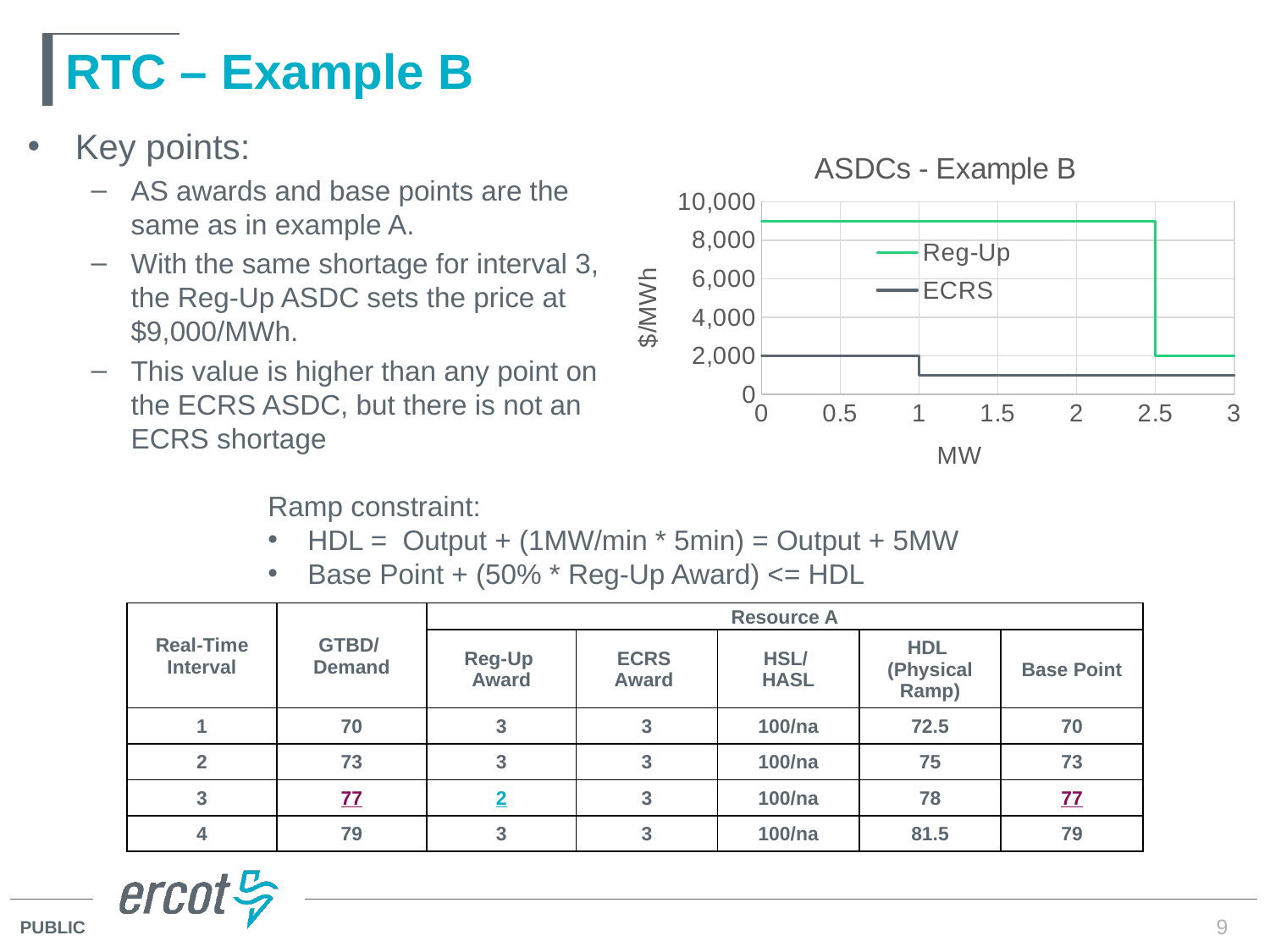
In the "ASDCs - Example B" chart, is the ECRS value at 2 MW greater or less than 2,000? less In the "ASDCs - Example B" chart, which series is higher at 0.5 MW, Reg-Up or ECRS? Reg-Up In the "ASDCs - Example B" chart, is the Reg-Up value at 3 MW greater or less than 4,000? less In the "ASDCs - Example B" chart, which series is higher at 2 MW, Reg-Up or ECRS? Reg-Up In the "ASDCs - Example B" chart, is the ECRS value at 0.5 MW greater or less than 4,000? less What kind of chart is the "ASDCs - Example B" chart? line chart How many series does the legend of the "ASDCs - Example B" chart list? 2 What is the title of the chart on the slide? ASDCs - Example B In the "ASDCs - Example B" chart, do the ECRS values rise or fall as MW increases from 0 to 3? fall In the "ASDCs - Example B" chart, what colour is the Reg-Up line? green In the "ASDCs - Example B" chart, do the Reg-Up values rise or fall as MW increases from 0 to 3? fall